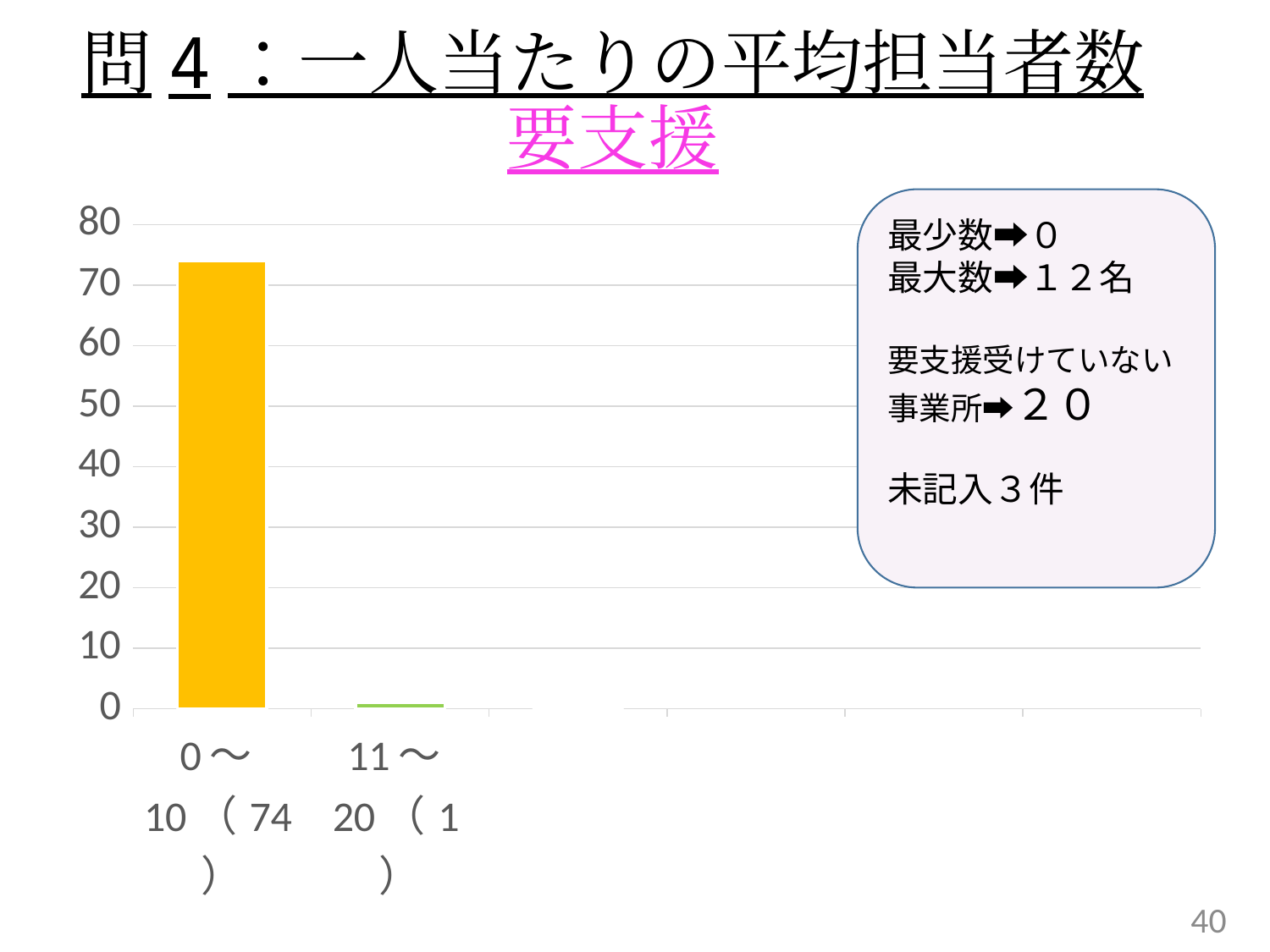
What colour is the bar for the 0～10 category? yellow/orange How many categories are plotted on the x axis of the chart? 2 Is the value for 0～10 greater or less than 70? greater Is the value for 11～20 greater or less than 10? less What is the value for the 11～20 category, as printed in its label? 1 What is the highest tick value shown on the vertical axis? 80 Which is larger, the value for 0～10 or the value for 11～20? 0～10 What kind of chart is shown on the slide? bar chart Which category has the lowest bar? 11～20 What is the difference between the values for 0～10 and 11～20? 73 What is the value for the 0～10 category, as printed in its label? 74 Which category has the highest bar? 0～10